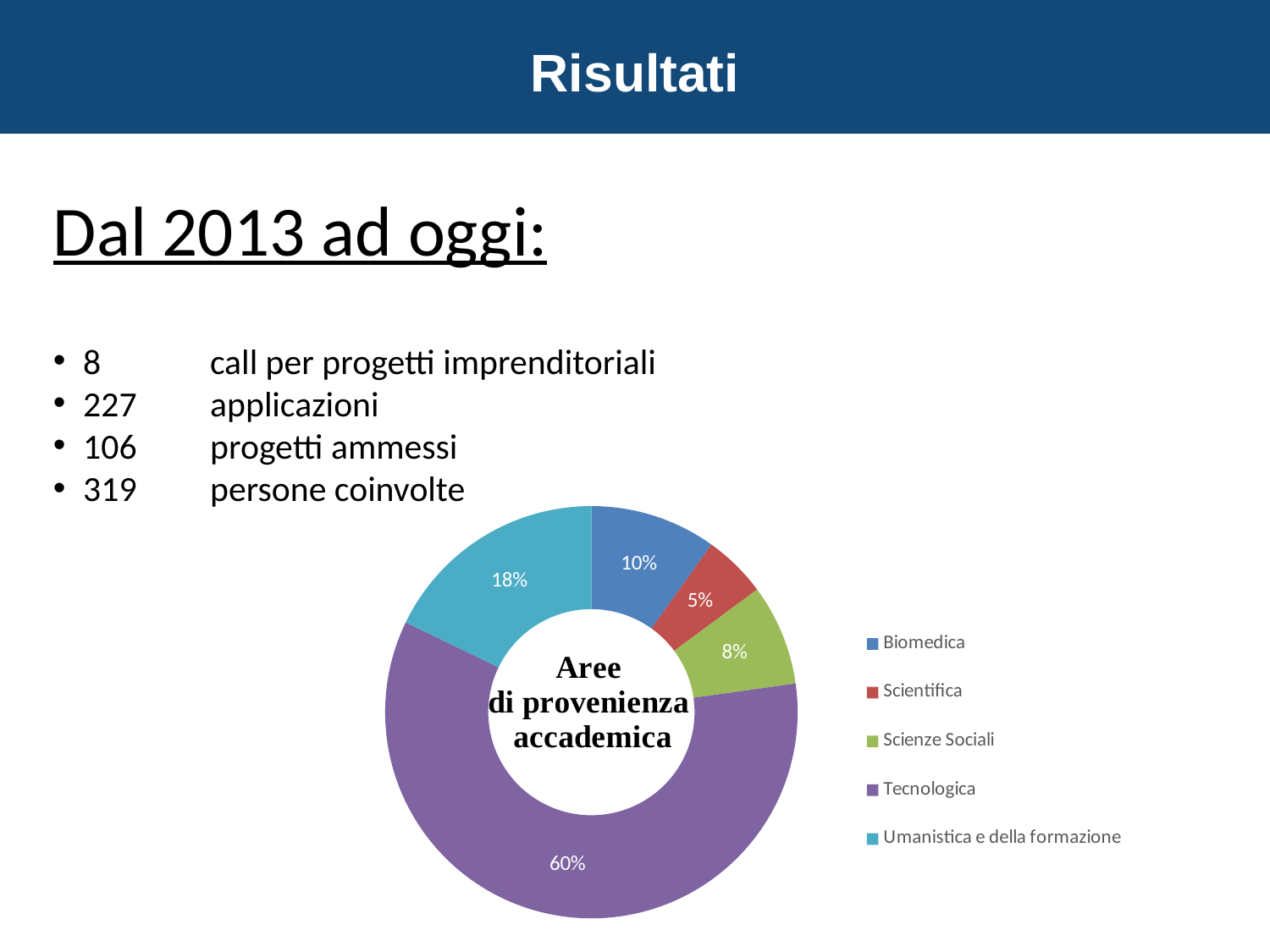
What share of the chart does Tecnologica represent? 60% What share of the chart does Biomedica represent? 10% Which is larger, the share for Biomedica or the share for Scienze Sociali? Biomedica What is the title shown in the centre of the doughnut chart? Aree di provenienza accademica What share of the chart does Umanistica e della formazione represent? 18% What share of the chart does Scientifica represent? 5% Which category has the smallest share of the chart? Scientifica How many categories does the legend of the chart list? 5 Which category has the largest share of the chart? Tecnologica What kind of chart is shown on the slide? Doughnut chart What share of the chart does Scienze Sociali represent? 8% What is the difference in percentage points between Tecnologica and Umanistica e della formazione? 42